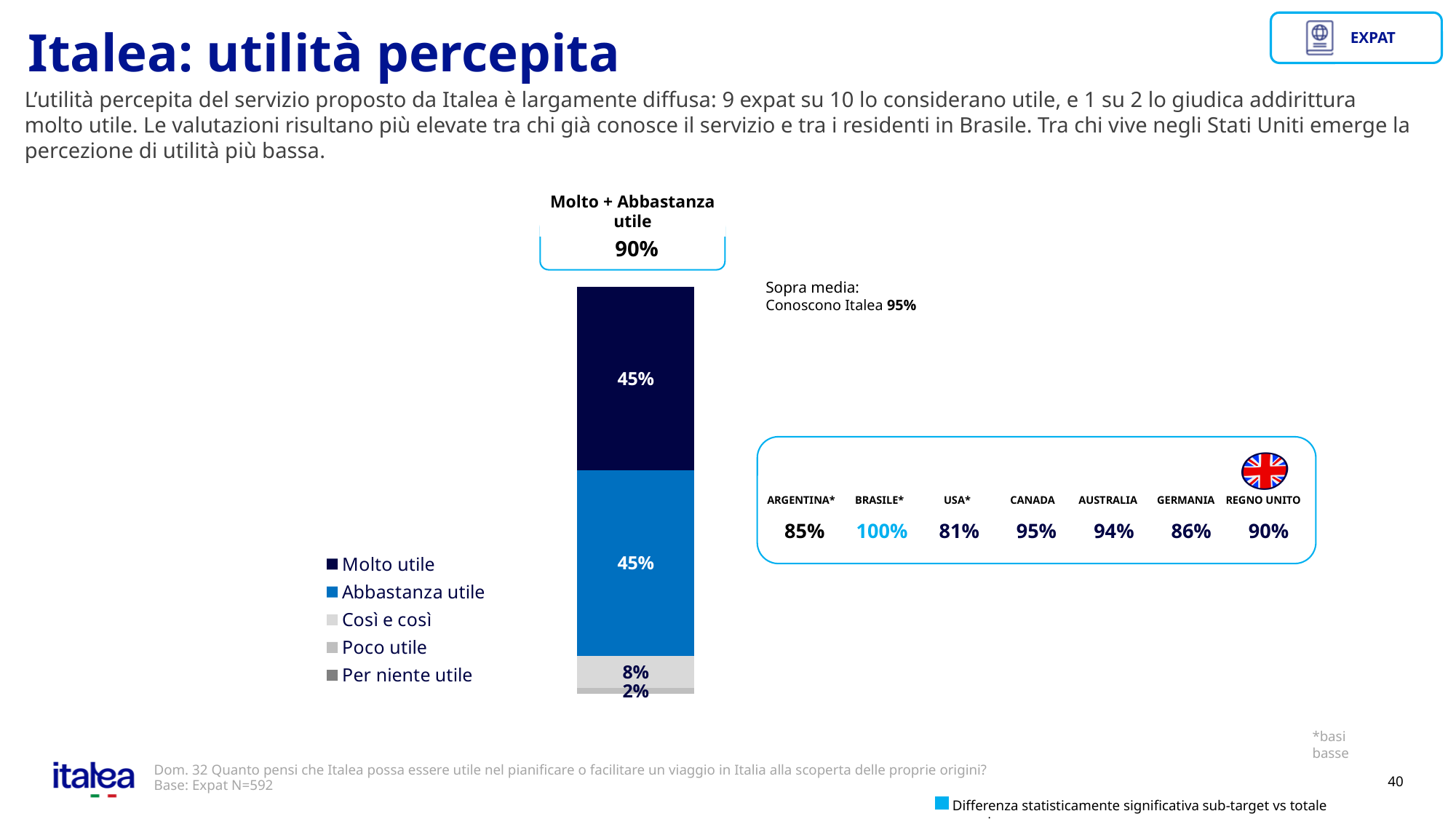
What is the value shown for "Poco utile" in the stacked bar chart? 2% What kind of chart is used to show the perceived usefulness of Italea? Stacked bar chart What is the difference in percentage points between the "Molto utile" segment and the "Così e così" segment? 37 percentage points How many bars does the stacked bar chart contain? 1 What is the value shown for "Così e così" in the stacked bar chart? 8% How many entries does the legend of the stacked bar chart list? 5 What is the difference in percentage points between the "Così e così" segment and the "Poco utile" segment? 6 percentage points What percentage of expats rate Italea as "Molto utile" in the stacked bar chart? 45% What combined value does the chart show for "Molto + Abbastanza utile"? 90% What percentage of expats rate Italea as "Abbastanza utile" in the stacked bar chart? 45% Which legend entry is shown in the darkest blue colour in the stacked bar chart? Molto utile Which is larger in the stacked bar chart: the "Così e così" segment or the "Poco utile" segment? Così e così